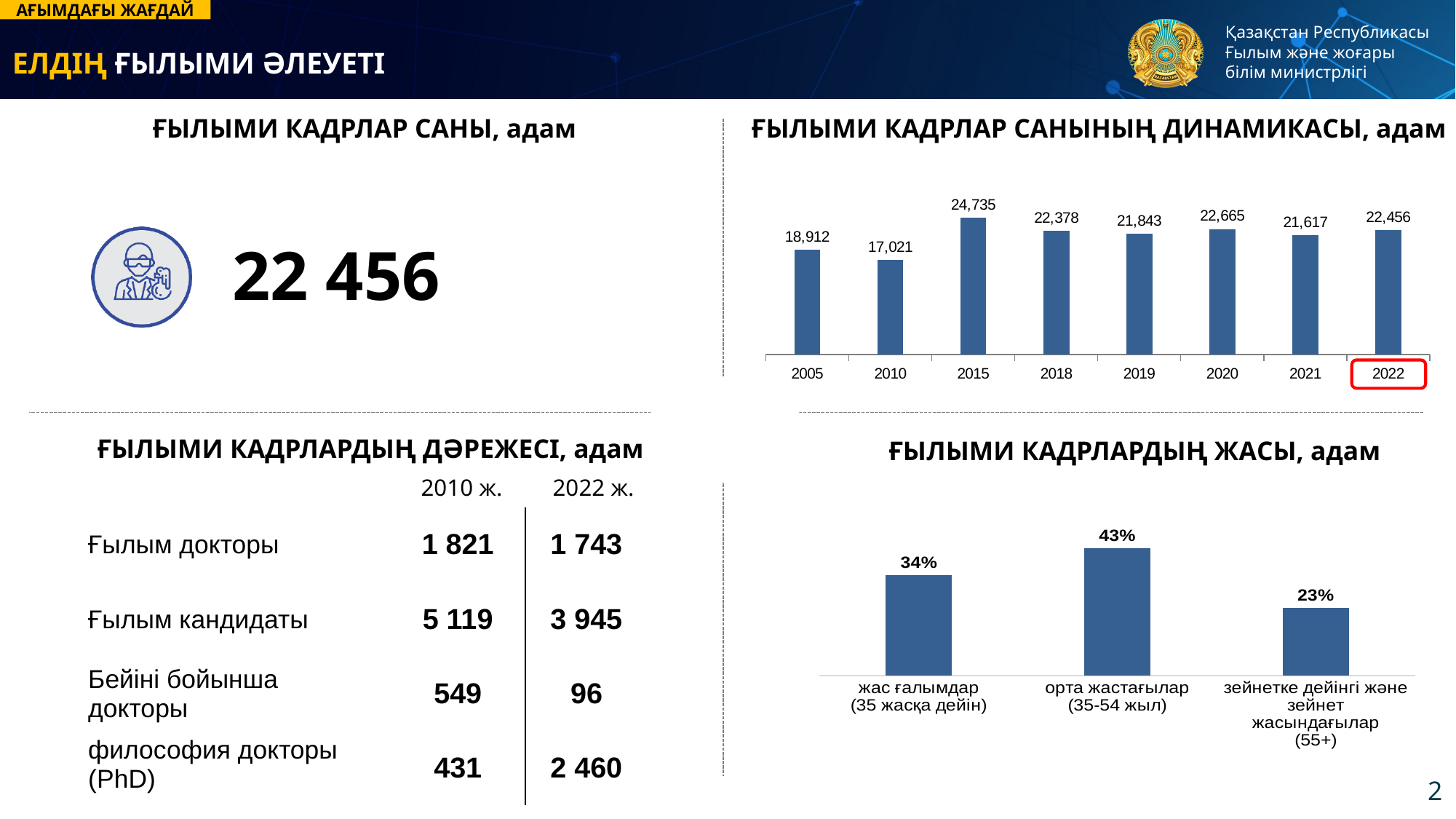
In the chart titled "ҒЫЛЫМИ КАДРЛАРДЫҢ ЖАСЫ, адам", which category has the lowest value? зейнетке дейінгі және зейнет жасындағылар (55+) How many years are shown in the chart titled "ҒЫЛЫМИ КАДРЛАР САНЫНЫҢ ДИНАМИКАСЫ, адам"? 8 What kind of chart is the one titled "ҒЫЛЫМИ КАДРЛАР САНЫНЫҢ ДИНАМИКАСЫ, адам"? Bar chart In the chart titled "ҒЫЛЫМИ КАДРЛАР САНЫНЫҢ ДИНАМИКАСЫ, адам", what is the value for 2022? 22,456 In the chart titled "ҒЫЛЫМИ КАДРЛАР САНЫНЫҢ ДИНАМИКАСЫ, адам", which is larger, the value for 2020 or the value for 2021? 2020 In the chart titled "ҒЫЛЫМИ КАДРЛАРДЫҢ ЖАСЫ, адам", what is the difference between the values for "орта жастағылар (35-54 жыл)" and "жас ғалымдар (35 жасқа дейін)"? 9% In the chart titled "ҒЫЛЫМИ КАДРЛАР САНЫНЫҢ ДИНАМИКАСЫ, адам", what is the difference between the values for 2015 and 2010? 7,714 In the chart titled "ҒЫЛЫМИ КАДРЛАР САНЫНЫҢ ДИНАМИКАСЫ, адам", which year has the lowest value? 2010 In the chart titled "ҒЫЛЫМИ КАДРЛАРДЫҢ ЖАСЫ, адам", what is the value for "орта жастағылар (35-54 жыл)"? 43% How many categories are shown in the chart titled "ҒЫЛЫМИ КАДРЛАРДЫҢ ЖАСЫ, адам"? 3 In the chart titled "ҒЫЛЫМИ КАДРЛАР САНЫНЫҢ ДИНАМИКАСЫ, адам", which year has the highest value? 2015 In the chart titled "ҒЫЛЫМИ КАДРЛАР САНЫНЫҢ ДИНАМИКАСЫ, адам", what is the value for 2015? 24,735